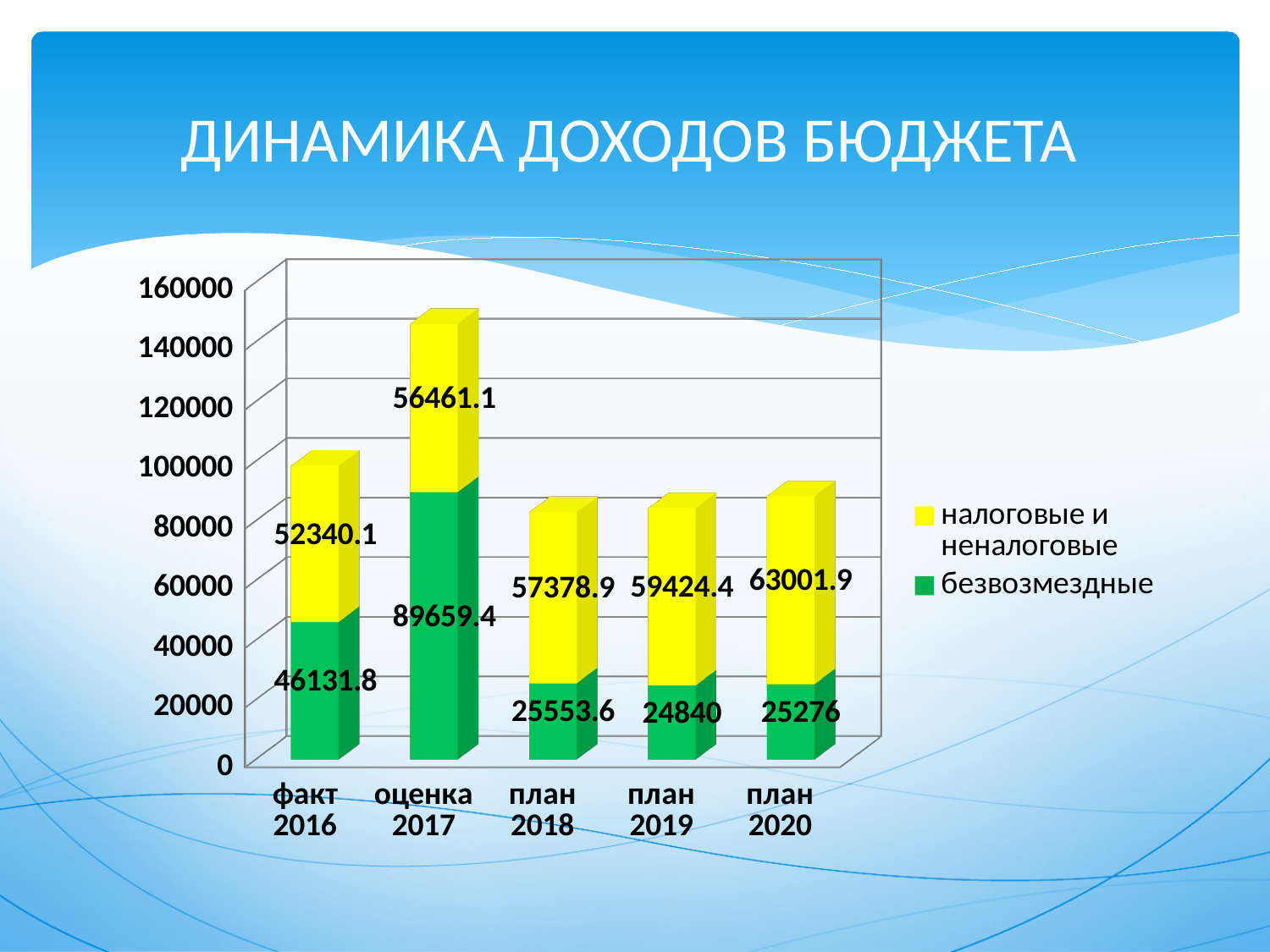
What is the value of налоговые и неналоговые for план 2020? 63001.9 What is the value of безвозмездные for оценка 2017? 89659.4 Which category has the highest value for безвозмездные? оценка 2017 What is the total of the stacked bar for план 2018? 82932.5 Which is larger: безвозмездные for факт 2016 or безвозмездные for план 2018? факт 2016 What is the value of безвозмездные for план 2019? 24840 How many series does the legend list? 2 What kind of chart is shown on the slide? stacked bar chart Which category has the lowest value for налоговые и неналоговые? факт 2016 How many categories are shown on the x axis? 5 What is the difference between the налоговые и неналоговые values for план 2020 and план 2019? 3577.5 What is the total of the stacked bar for оценка 2017? 146120.5